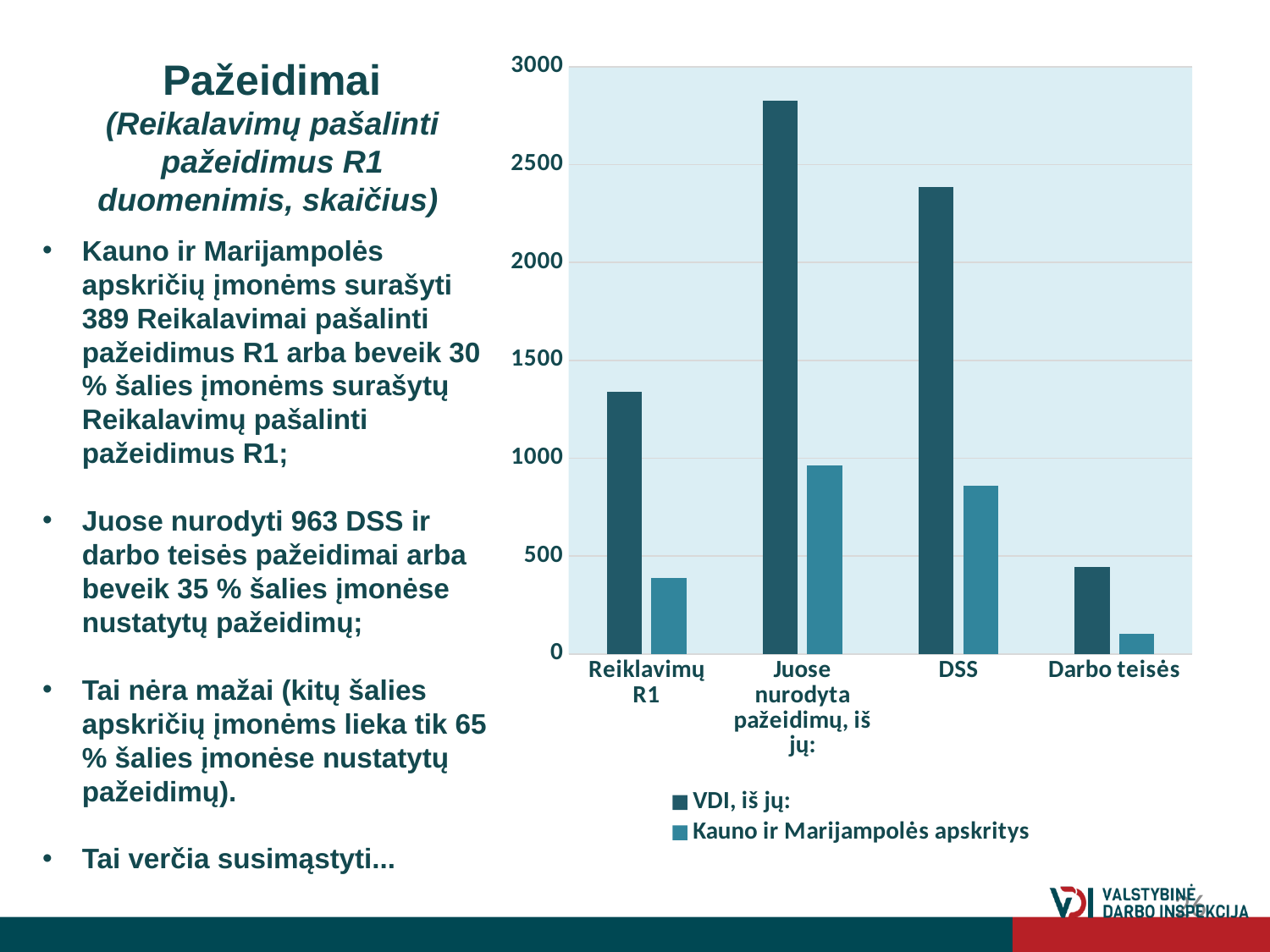
Is the 'VDI, iš jų:' value for 'Reiklavimų R1' greater or less than 1000? greater What kind of chart is shown on the slide? bar chart For the 'VDI, iš jų:' series, which is larger: the value for DSS or the value for 'Reiklavimų R1'? DSS Which series is shown in the lighter blue bars? Kauno ir Marijampolės apskritys Which category has the lowest value for the 'Kauno ir Marijampolės apskritys' series? Darbo teisės Which category has the lowest value for the 'VDI, iš jų:' series? Darbo teisės How many categories are shown on the x axis of the chart? 4 Which category has the highest value for the 'VDI, iš jų:' series? Juose nurodyta pažeidimų, iš jų: Is the 'VDI, iš jų:' value for DSS greater or less than 2500? less How many series does the chart legend list? 2 Is the 'VDI, iš jų:' value for 'Juose nurodyta pažeidimų, iš jų:' greater or less than 2500? greater